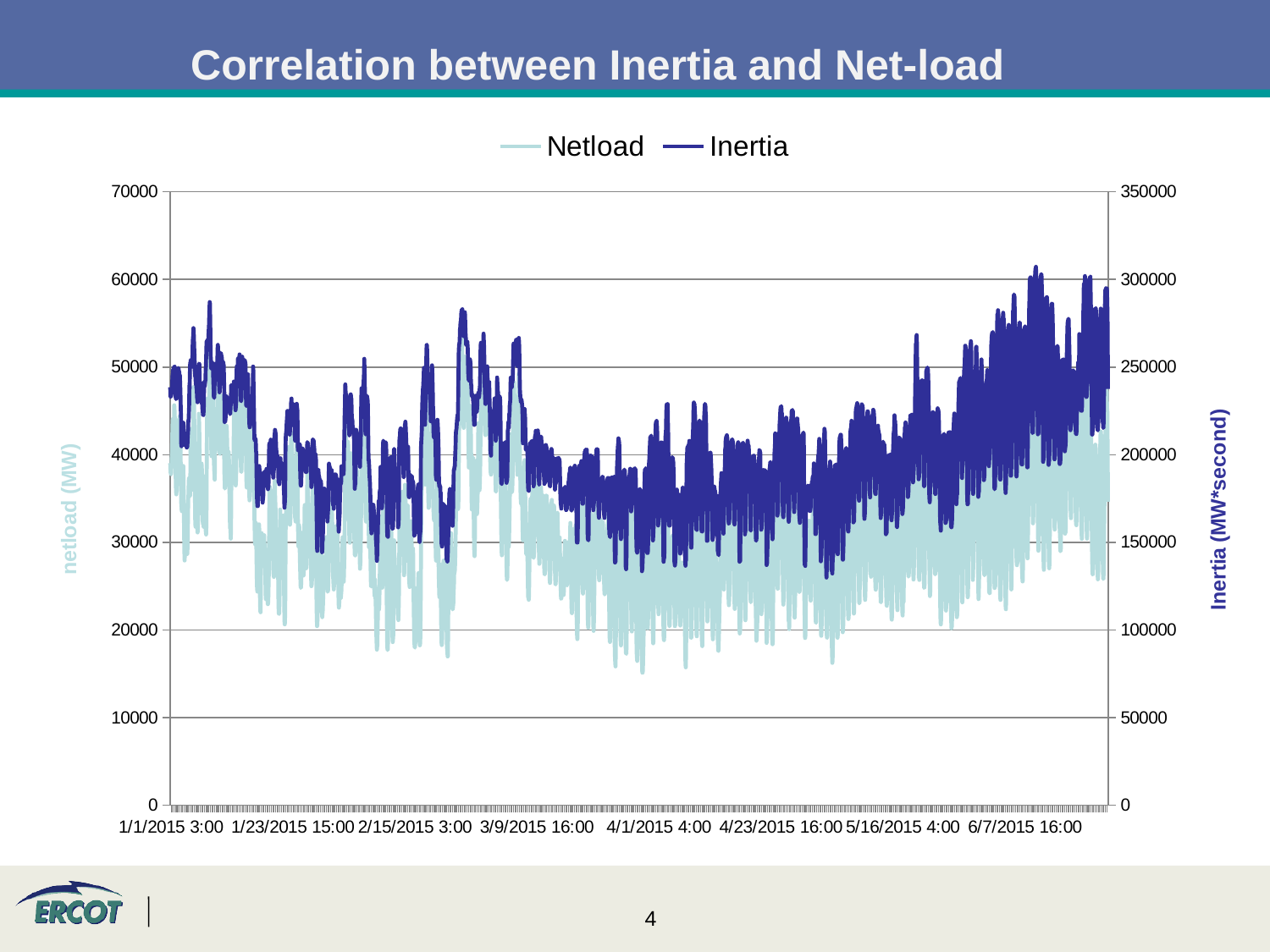
How many series does the legend list? 2 What is the maximum value shown on the left (netload) axis? 70000 Is the lowest Inertia value reached in April 2015 greater or less than 150000? less Does the Inertia series generally rise or fall from April 2015 to June 2015? rise Which series is plotted in the darker blue colour? Inertia What kind of chart is shown on the slide? line chart What is the title of the chart? Correlation between Inertia and Net-load What is the maximum value shown on the right (Inertia) axis? 350000 Is the highest Netload value in early January 2015 greater or less than 40000? greater What are the two series named in the legend? Netload and Inertia Is the highest Inertia value in June 2015 greater or less than 250000? greater